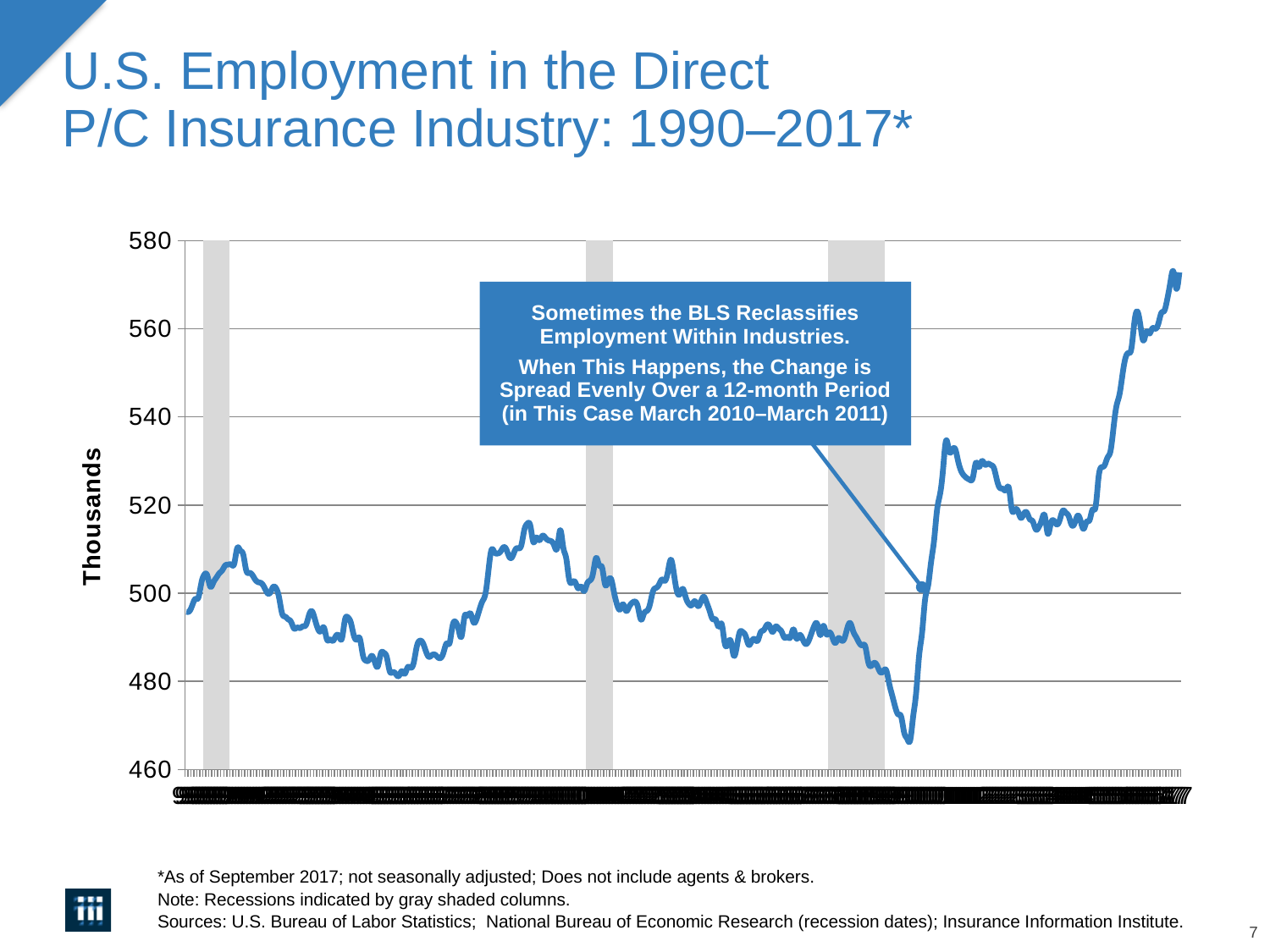
Which is larger, the value at the start of the series or the value at the end of the series? The value at the end of the series Is the value at the left-hand start of the line (the earliest point) greater or less than 500? less What is the label on the vertical axis of the chart? Thousands Over the whole period shown, does employment rise or fall from the start of the line to the end? Rise What kind of chart is shown on the slide? Line chart Is the value at the right-hand end of the line (the most recent point) greater or less than 560? greater What is the title of the chart on the slide? U.S. Employment in the Direct P/C Insurance Industry: 1990–2017* Does the line ever rise above 580 on the chart? No Does the line reach its highest value at the beginning or at the end of the period shown? At the end